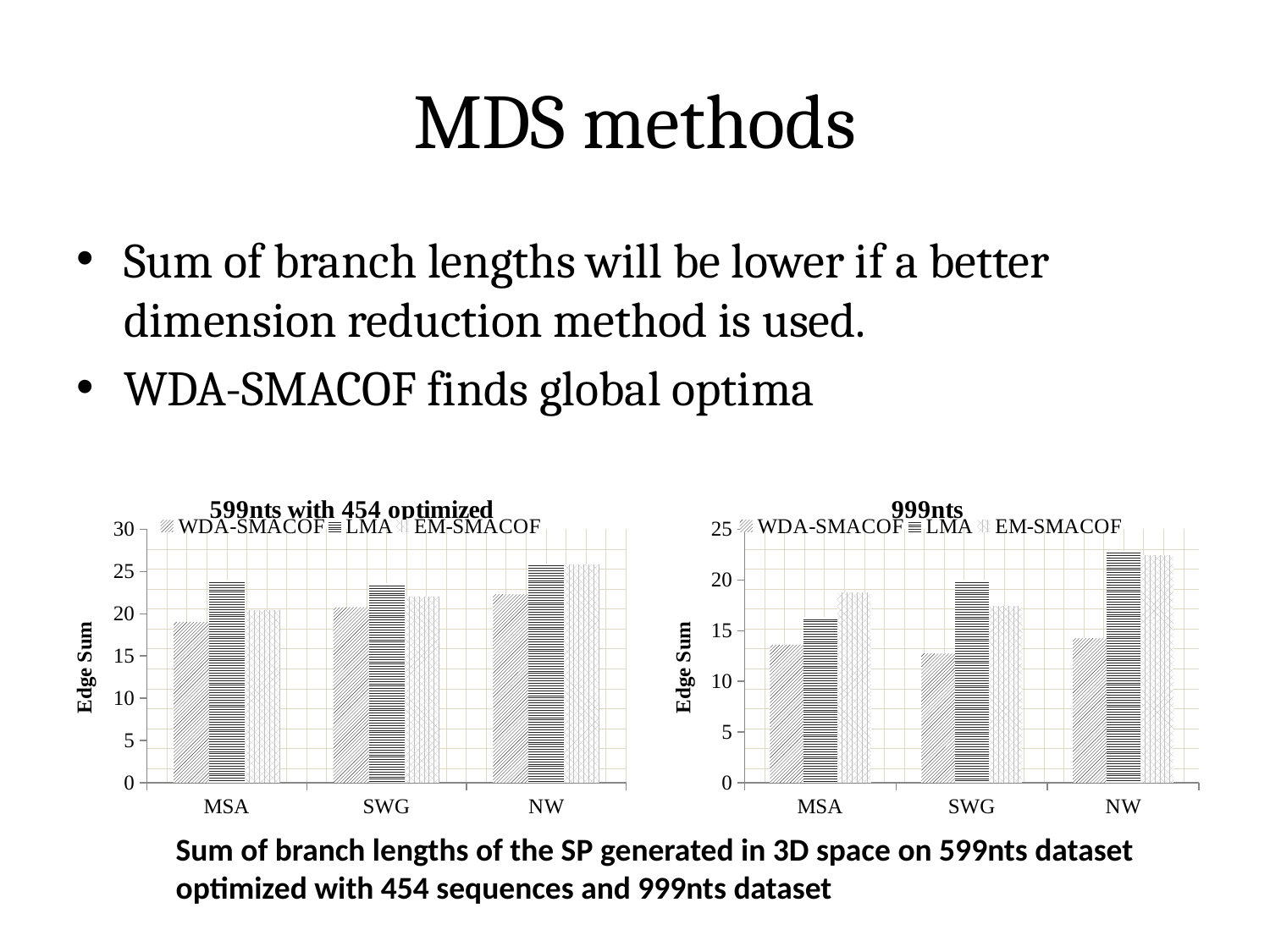
In the '999nts' chart, is the value for WDA-SMACOF at SWG greater or less than 15? less How many categories are shown on the x axis of the '599nts with 454 optimized' chart? 3 In the '999nts' chart, which is larger at MSA: EM-SMACOF or WDA-SMACOF? EM-SMACOF What kind of chart is the '599nts with 454 optimized' chart? bar chart In the '599nts with 454 optimized' chart, is the value for LMA at MSA greater or less than 20? greater In the '999nts' chart, which category has the highest LMA value? NW What is the y-axis label of the '999nts' chart? Edge Sum How many series does the legend of the '999nts' chart list? 3 In the '999nts' chart, is the value for LMA at NW greater or less than 20? greater What is the title of the chart on the left of the slide? 599nts with 454 optimized In the '999nts' chart, which category has the lowest WDA-SMACOF value? SWG